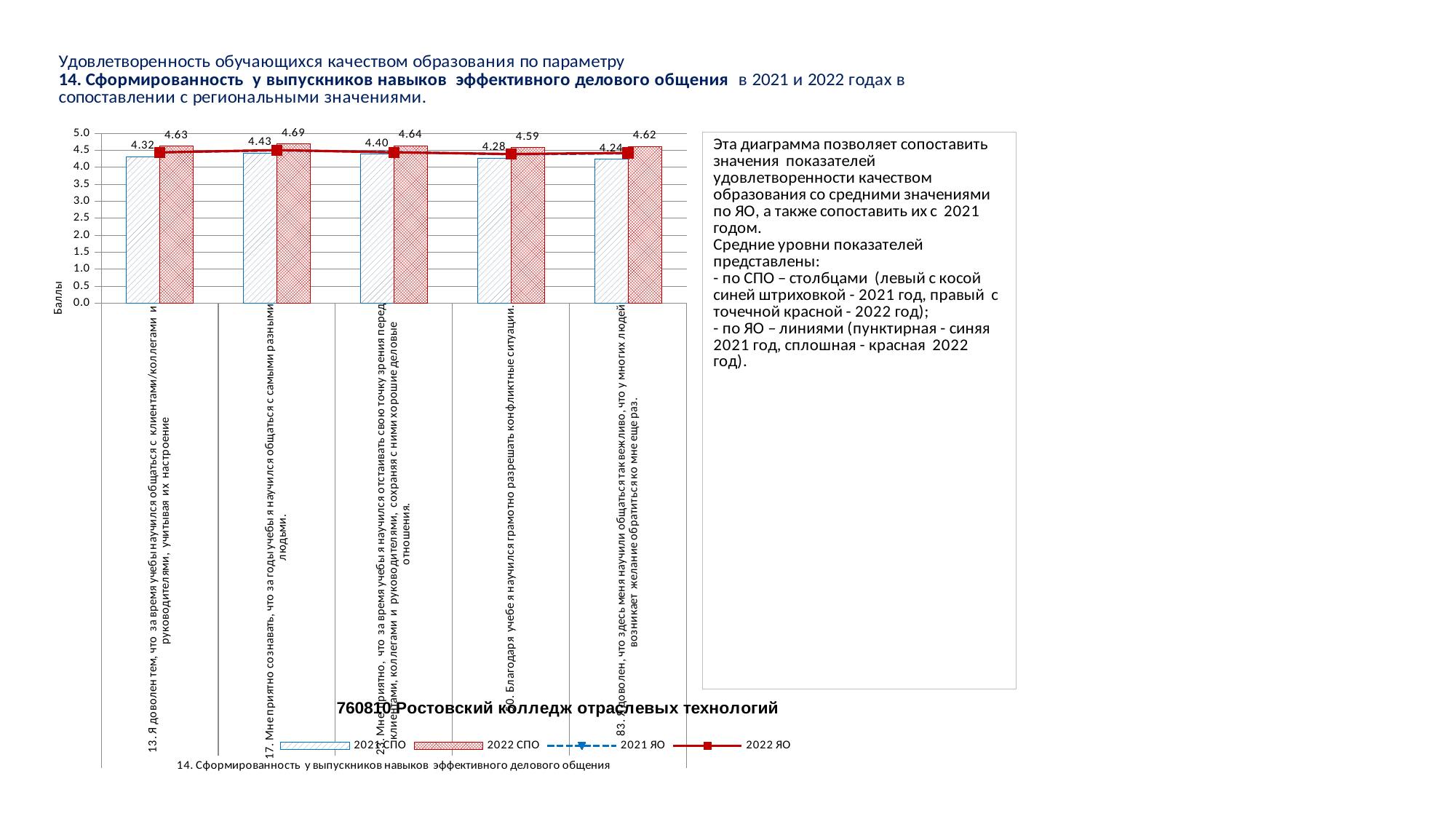
What is the value of the 2021 СПО bar for category 83 ("Я доволен, что здесь меня научили общаться так вежливо...")? 4.24 What is the value of the 2022 СПО bar for category 13 ("Я доволен тем, что за время учебы научился общаться с клиентами/коллегами и руководителями...")? 4.63 Is the 2021 СПО value for category 83 greater or less than 4.0? greater How many series does the chart legend list? 4 For category 17, what is the difference between the 2022 СПО value and the 2021 СПО value? 0.26 Which category has the lowest 2021 СПО value? 83. Я доволен, что здесь меня научили общаться так вежливо... (4.24) How many categories (statements) are shown on the x axis of the chart? 5 For category 13, what is the difference between the 2022 СПО value and the 2021 СПО value? 0.31 Which category has the highest 2022 СПО value? 17. Мне приятно сознавать, что за годы учебы я научился общаться с самыми разными людьми (4.69) What kind of chart is shown on the slide? A combined bar and line chart